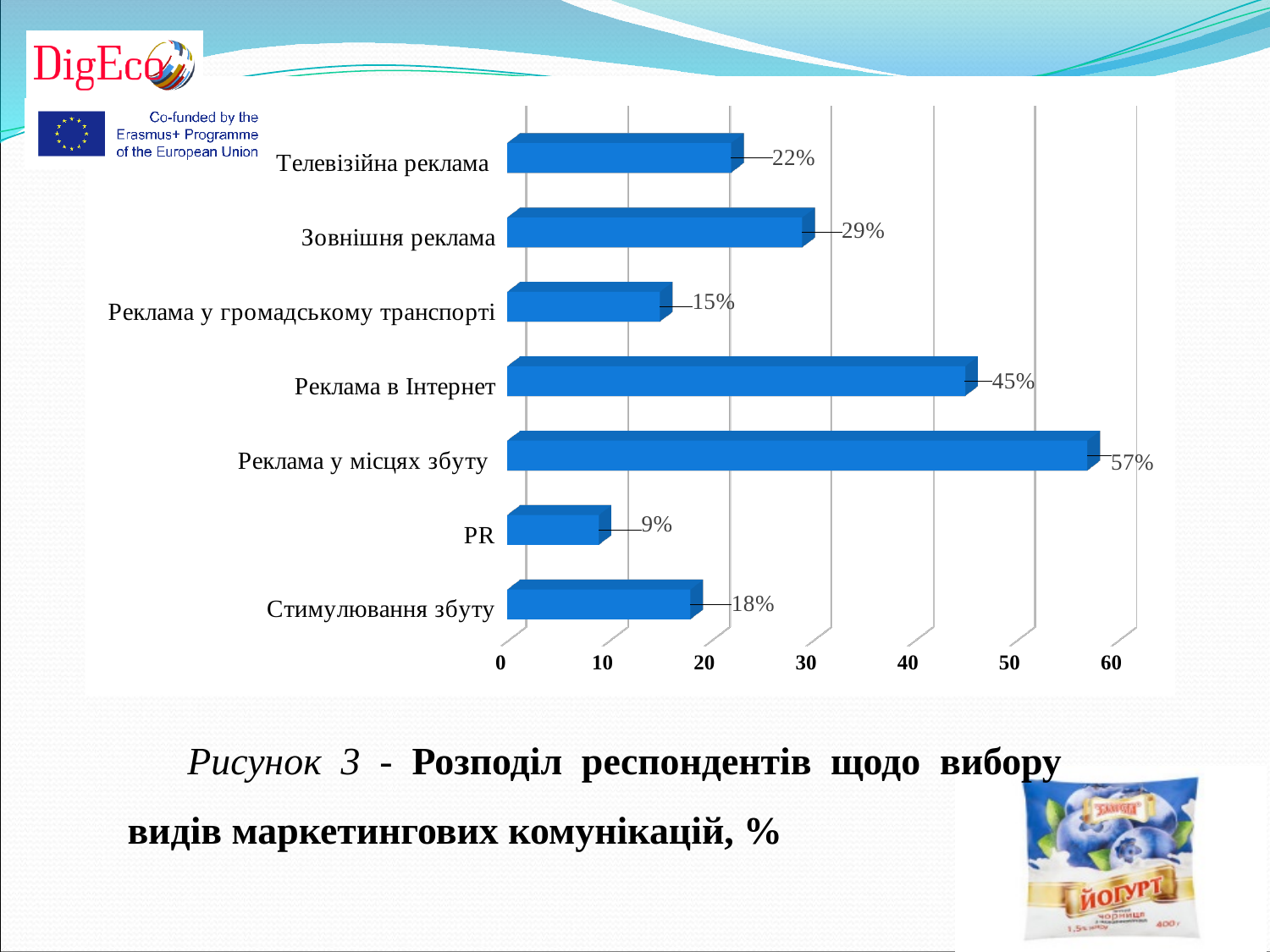
What is the difference between Телевізійна реклама and Стимулювання збуту? 4% What is the value for PR? 9% What is the difference between Реклама у місцях збуту and Реклама в Інтернет? 12% How many categories are shown in the chart? 7 What kind of chart is shown on the slide? bar chart Which category has the lowest value? PR What is the value for Реклама в Інтернет? 45% Is the value for Реклама у місцях збуту greater or less than 50? greater Which is larger, Зовнішня реклама or Реклама у громадському транспорті? Зовнішня реклама What is the caption of the figure below the chart? Рисунок 3 - Розподіл респондентів щодо вибору видів маркетингових комунікацій, % Which category has the highest value? Реклама у місцях збуту What is the value for Зовнішня реклама? 29%